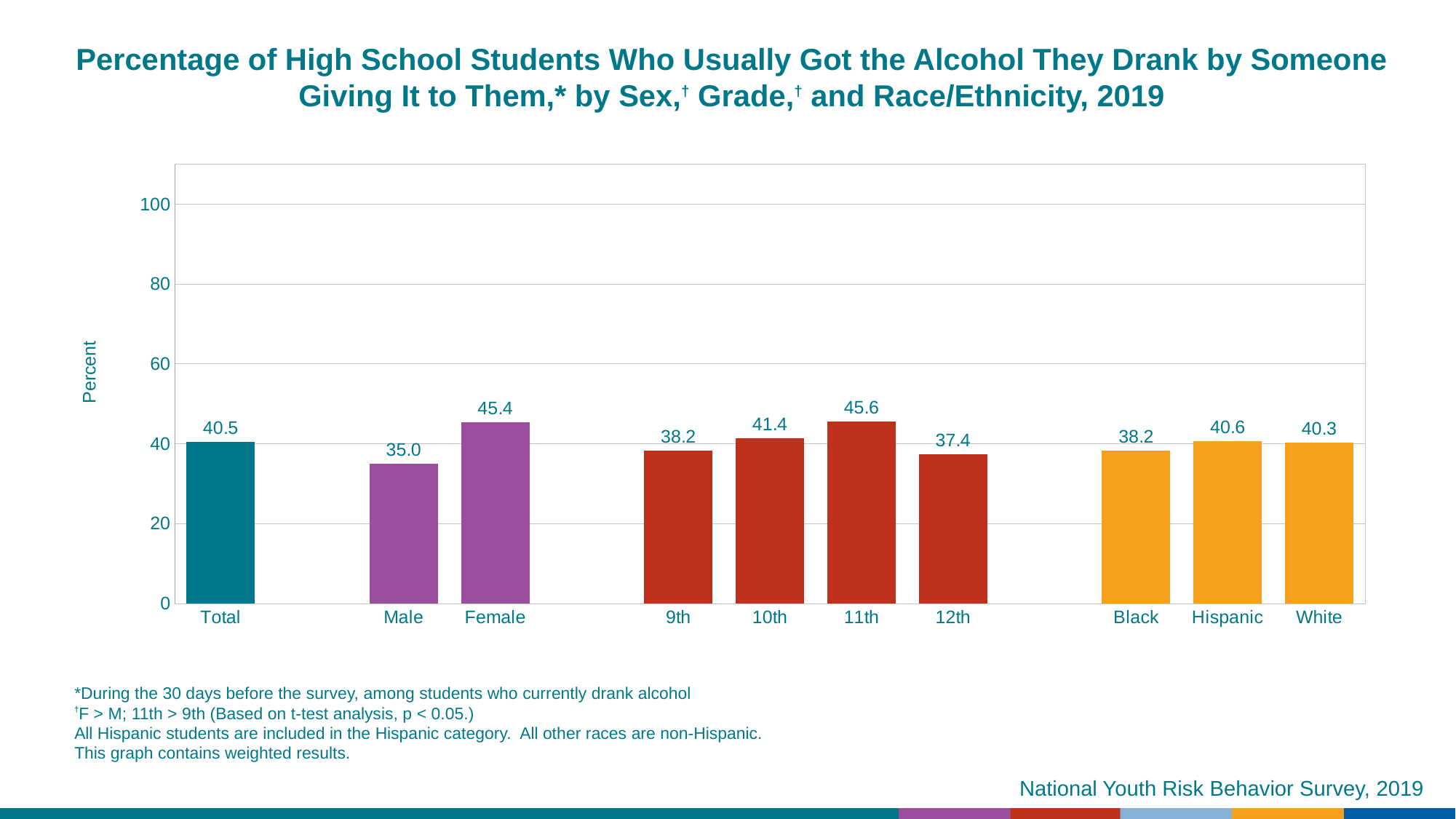
What is the value for Hispanic students? 40.6 What is the difference between the 11th grade and 9th grade values? 7.4 Which category has the highest value? 11th What kind of chart is shown on the slide? bar chart What is the difference between the Female and Male values? 10.4 Is the value for Male greater or less than 40? less What is the label of the y axis? Percent What is the value for Female? 45.4 Which category has the lowest value? Male Which is larger, the value for 10th grade or the value for 12th grade? 10th How many categories are shown on the x axis? 10 What is the value for 12th grade? 37.4